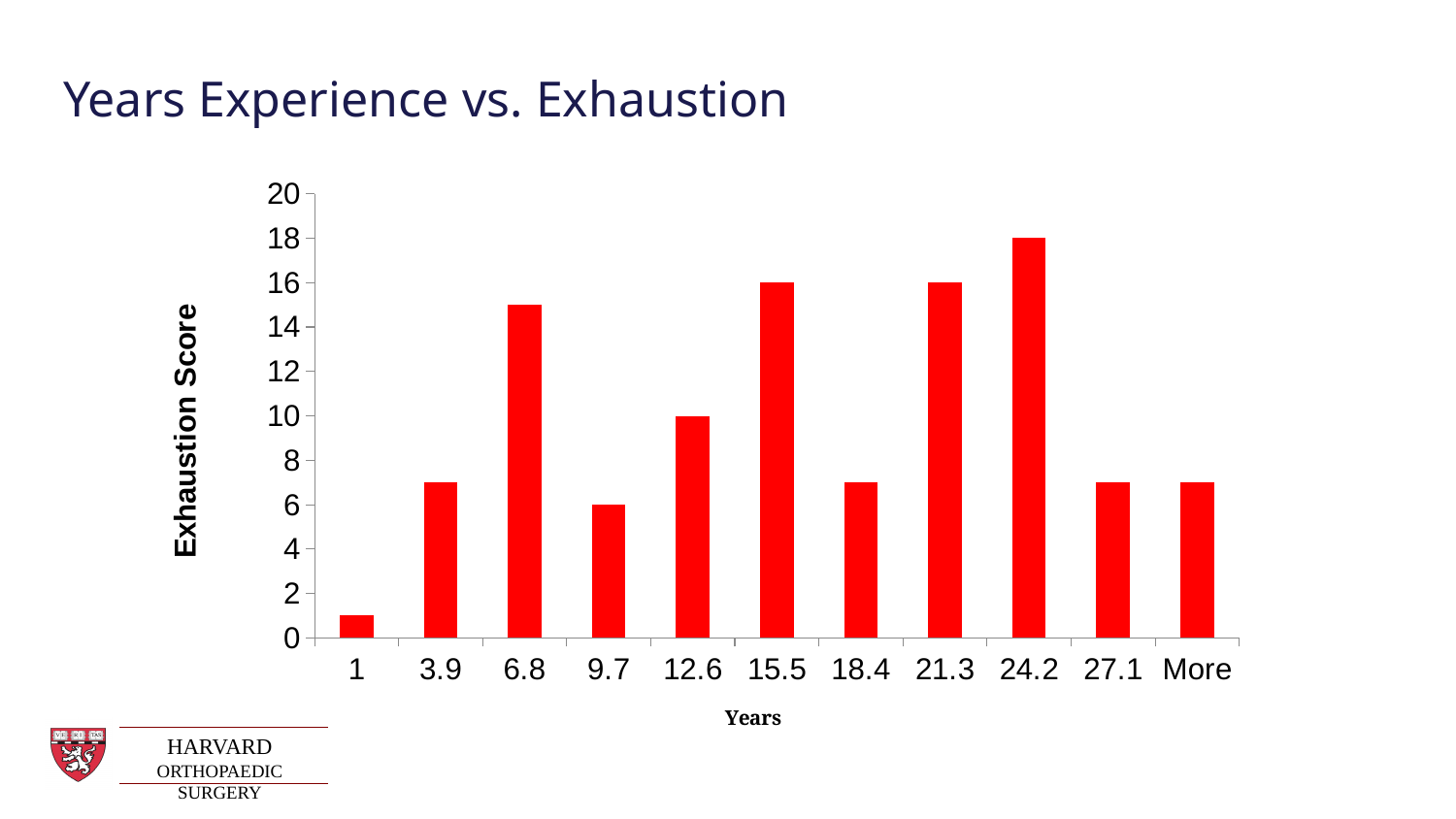
Which has a higher exhaustion score, 6.8 years or 9.7 years? 6.8 Is the exhaustion score for the 27.1 years category greater or less than 8? less Is the exhaustion score for the 6.8 years category greater or less than 14? greater Which years category has the lowest exhaustion score? 1 What is the label of the y axis? Exhaustion Score How many categories are shown on the x axis? 11 What is the exhaustion score for the 9.7 years category? 6 What is the exhaustion score for the 24.2 years category? 18 What type of chart is shown on the slide? bar chart Which years category has the highest exhaustion score? 24.2 What is the difference between the exhaustion scores for 24.2 years and 15.5 years? 2 What is the exhaustion score for the 12.6 years category? 10